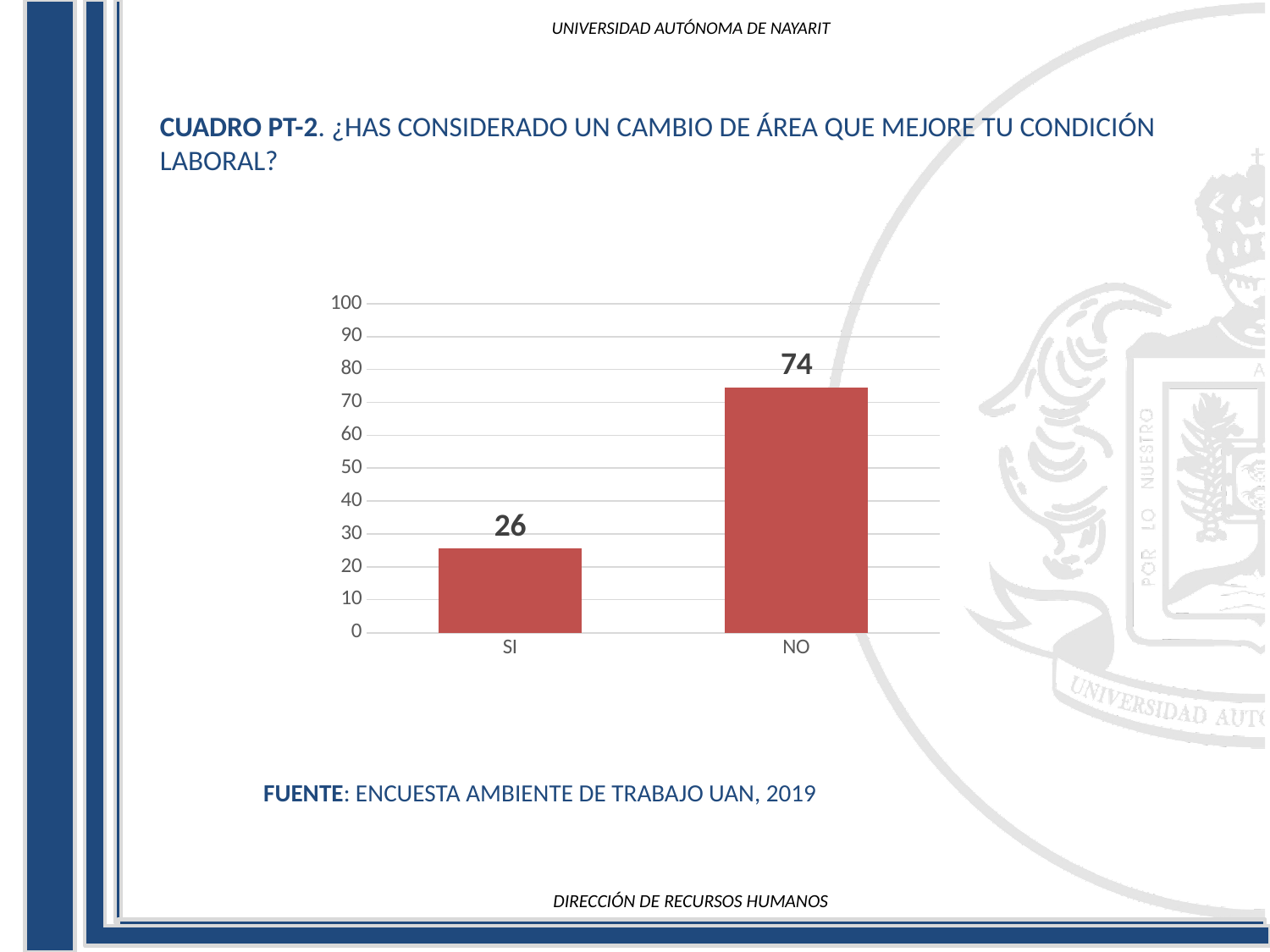
Which category has the lowest value? SI How many categories are shown on the x axis? 2 What is the maximum value shown on the y axis? 100 Which is larger, the value for SI or the value for NO? NO What is the value for NO? 74 Is the value for NO greater or less than 50? greater What is the value for SI? 26 What is the total of the values for SI and NO? 100 What is the difference between the values for NO and SI? 48 Is the value for SI greater or less than 30? less What kind of chart is shown on the slide? bar chart Which category has the highest value? NO